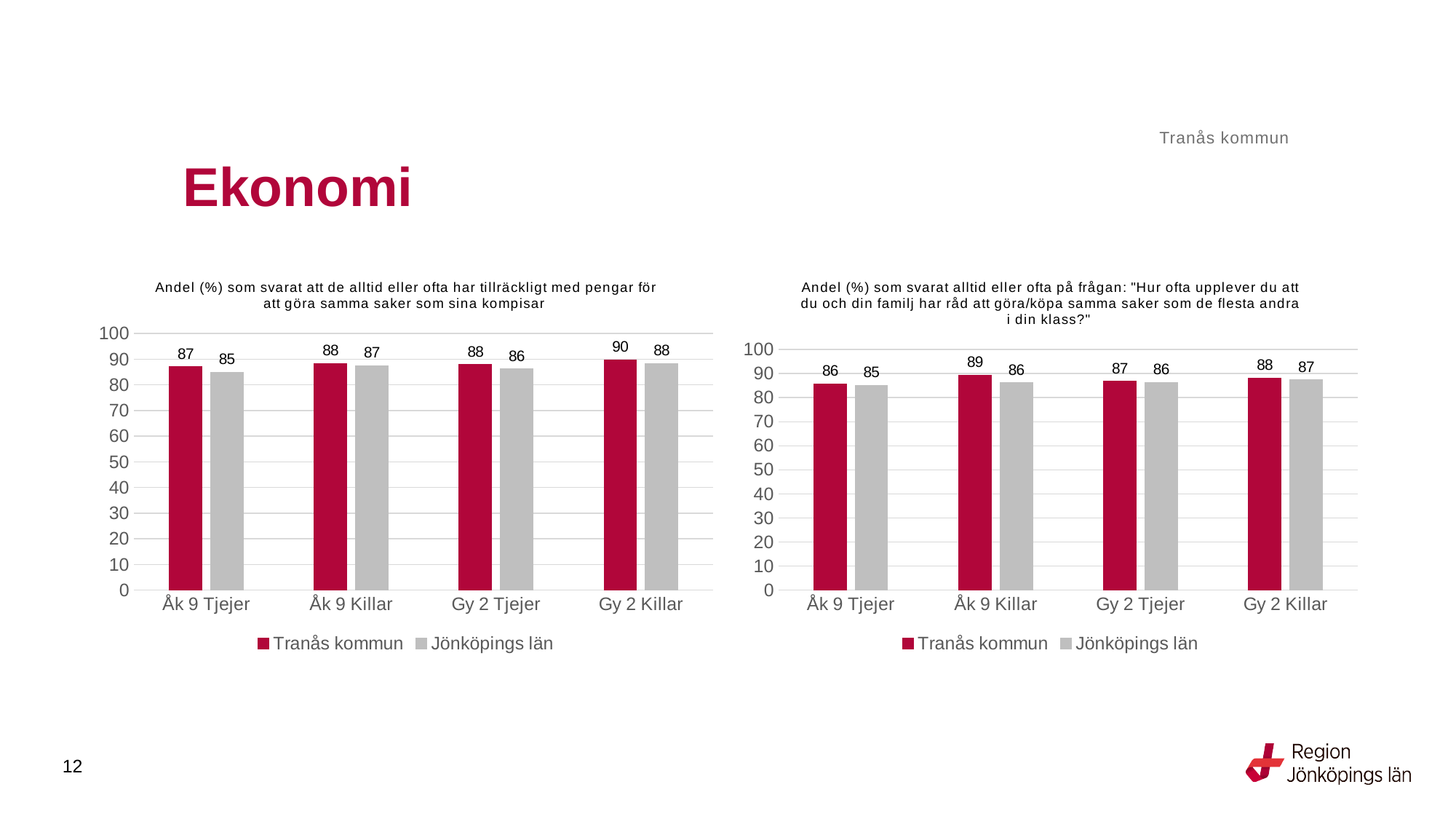
In the left chart, what is the difference between Tranås kommun and Jönköpings län for Åk 9 Tjejer? 2 In the left chart, how many categories are shown on the x axis? 4 In the left chart, what is the value for Tranås kommun for Gy 2 Killar? 90 In the right chart, what is the value for Jönköpings län for Gy 2 Killar? 87 How many series does the legend of the right chart list? 2 In the right chart, what is the difference between Tranås kommun and Jönköpings län for Åk 9 Killar? 3 What type of chart is the left chart? Bar chart In the right chart, which category has the lowest value for Jönköpings län? Åk 9 Tjejer In the left chart, which category has the highest value for Tranås kommun? Gy 2 Killar In the left chart, what is the value for Jönköpings län for Åk 9 Tjejer? 85 In the right chart, what is the value for Tranås kommun for Åk 9 Killar? 89 In the left chart, do the Tranås kommun values rise or fall from Åk 9 Tjejer to Gy 2 Killar? Rise